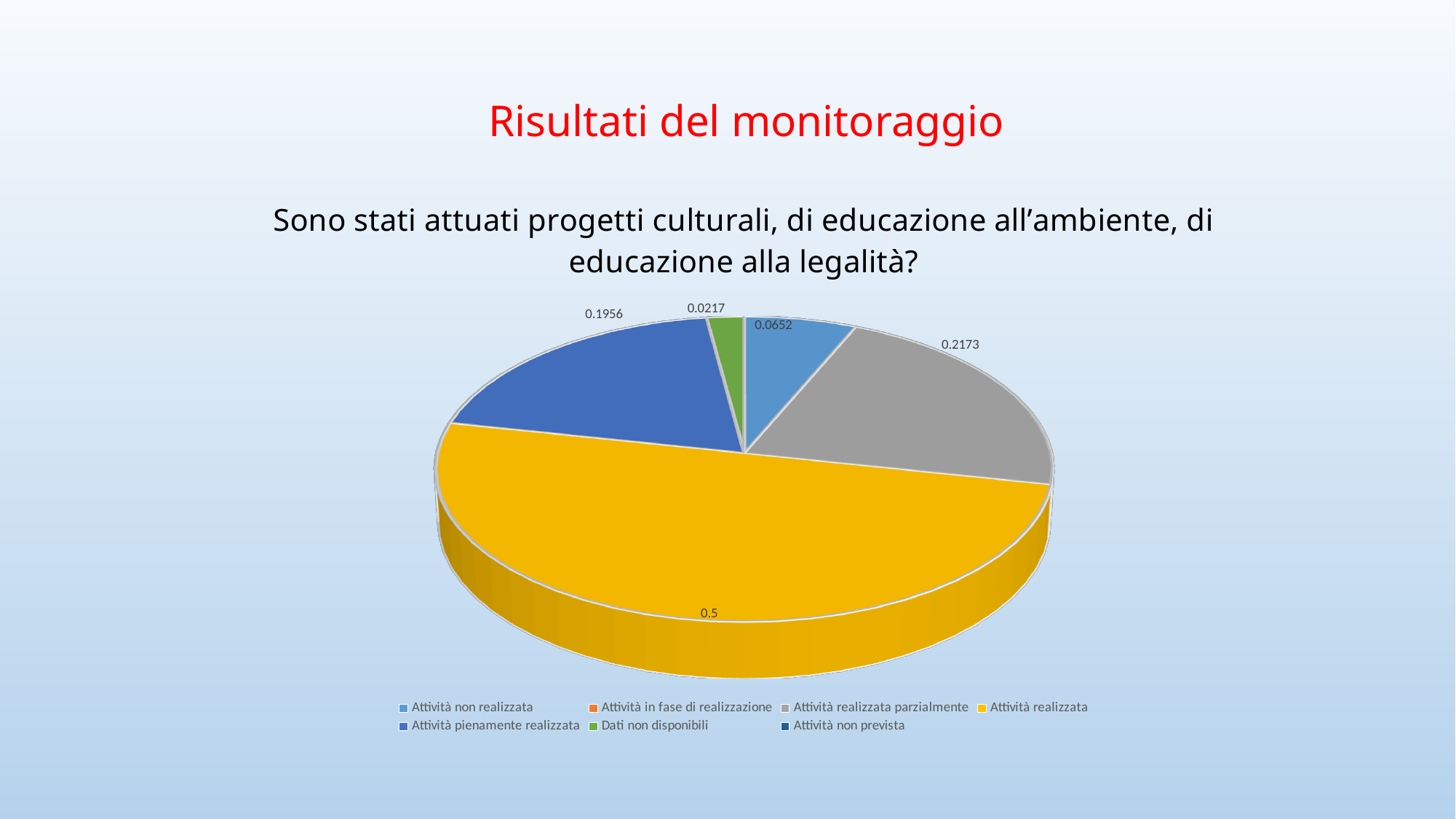
What is the value for "Attività pienamente realizzata"? 0.1956 How many entries does the legend list? 7 What is the value for "Attività non realizzata"? 0.0652 What colour is the slice for "Attività realizzata"? Yellow Which category has the largest slice of the pie? Attività realizzata Which category with a visible slice has the smallest value? Dati non disponibili What is the value for "Attività realizzata parzialmente"? 0.2173 What is the difference between the values for "Attività realizzata" and "Attività realizzata parzialmente"? 0.2827 What is the value for "Dati non disponibili"? 0.0217 What is the value for "Attività realizzata"? 0.5 Which is larger, the value for "Attività realizzata parzialmente" or the value for "Attività pienamente realizzata"? Attività realizzata parzialmente What kind of chart is shown on the slide? Pie chart